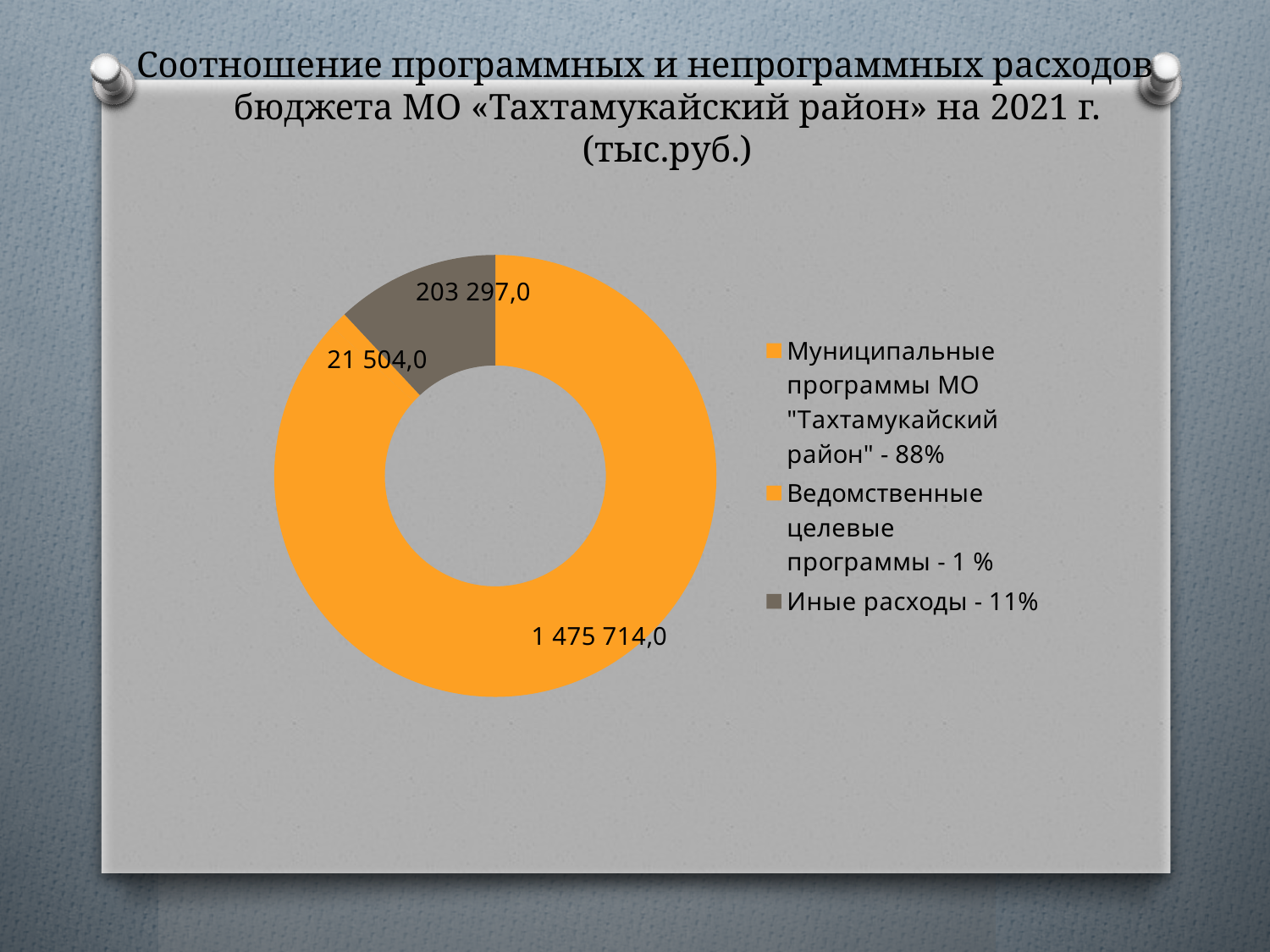
What is the value for Муниципальные программы МО "Тахтамукайский район"? 1 475 714,0 What unit is stated in the chart title? тыс.руб. What kind of chart is shown on the slide? doughnut chart How many categories does the chart show? 3 Which category has the smallest value? Ведомственные целевые программы What is the difference between the values for Иные расходы and Ведомственные целевые программы? 181 793,0 Which category has the largest value? Муниципальные программы МО "Тахтамукайский район" Which is larger: the value for Иные расходы or the value for Ведомственные целевые программы? Иные расходы What share of the chart do Иные расходы make up, according to the legend? 11% What share of the chart do Муниципальные программы МО "Тахтамукайский район" make up, according to the legend? 88% What is the value for Иные расходы? 203 297,0 What is the value for Ведомственные целевые программы? 21 504,0